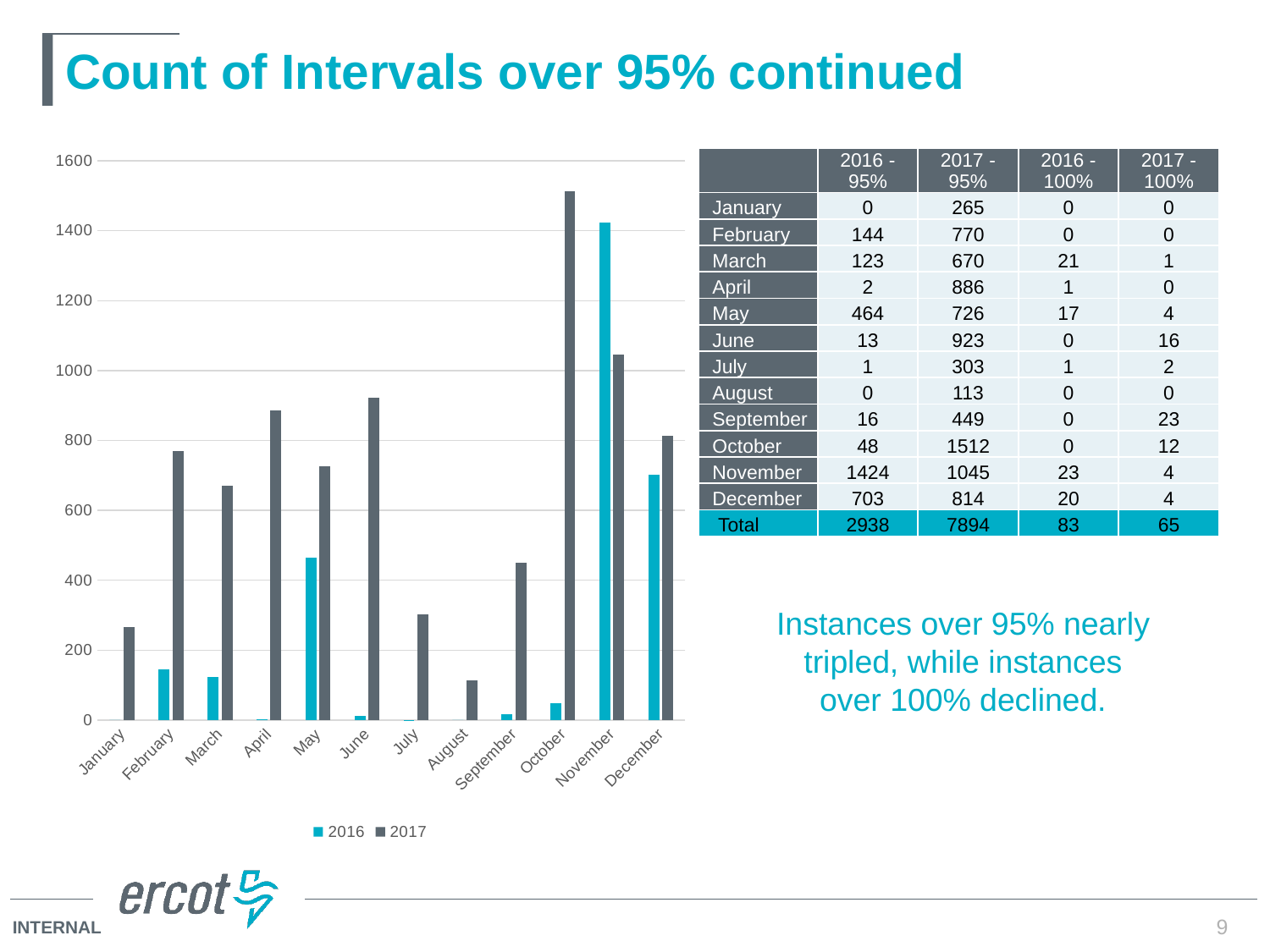
Which is larger in the chart, the 2016 bar or the 2017 bar for November? 2016 What kind of chart is shown on the slide? bar chart Which month has the highest 2017 bar in the chart? October What are the two legend entries of the chart? 2016 and 2017 Is the 2016 value for May greater or less than 600? less According to the slide, what is the 2017 - 95% value for October? 1512 How many series does the chart legend list? 2 Which month has the highest 2016 bar in the chart? November Is the 2017 value for October greater or less than 1400? greater Which is larger in the chart, the 2016 bar or the 2017 bar for June? 2017 According to the slide, what is the difference between the 2017 - 95% and 2016 - 95% values for February? 626 How many months are shown along the x axis of the chart? 12